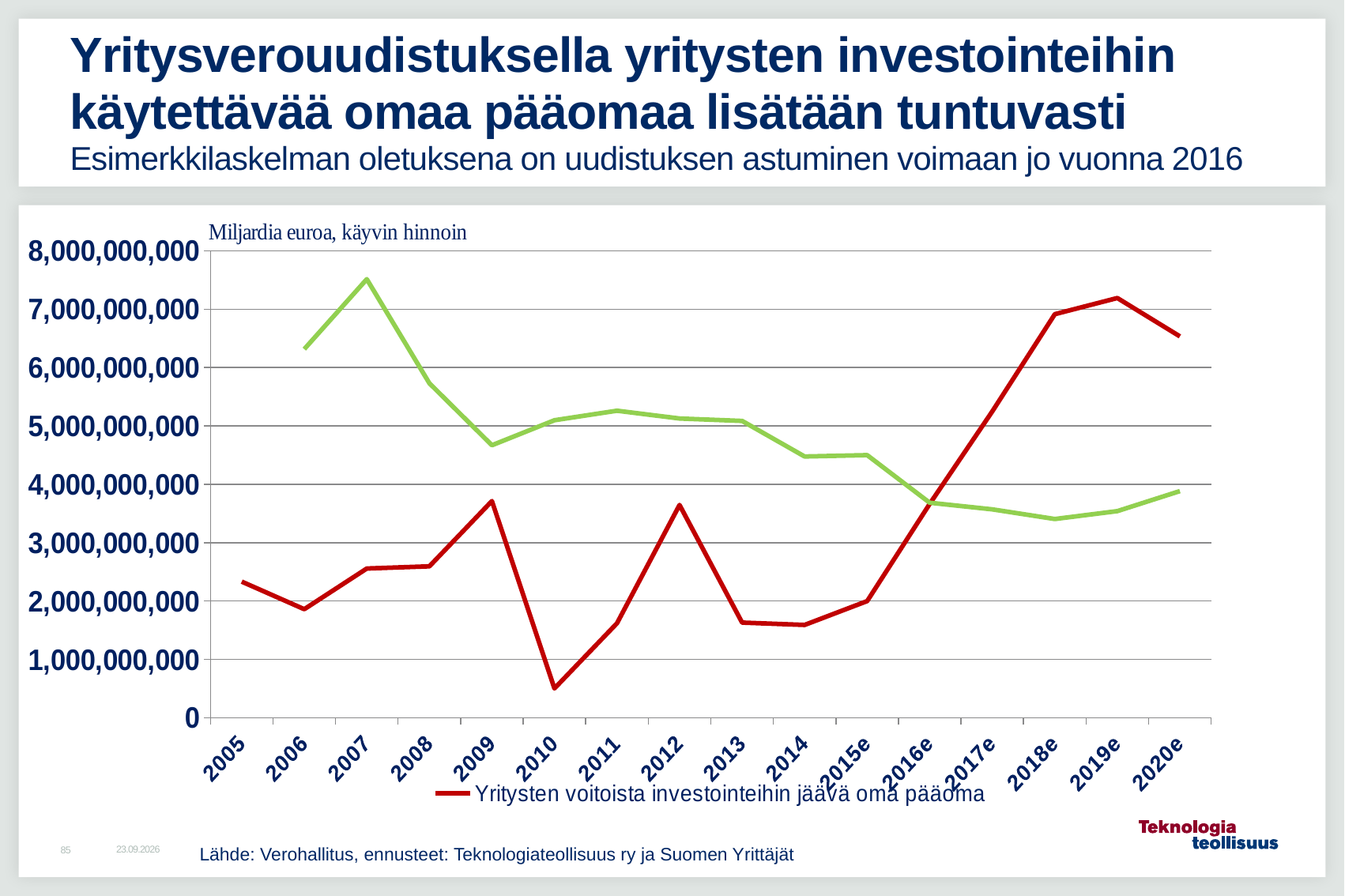
What kind of chart is shown on the slide? line chart In 2010, which line has the larger value, the red line or the green line? the green line In which year does the red line (Yritysten voitoista investointeihin jäävä oma pääoma) reach its lowest value? 2010 What unit note is printed above the y axis of the chart? Miljardia euroa, käyvin hinnoin In which year does the red line (Yritysten voitoista investointeihin jäävä oma pääoma) reach its highest value? 2019e Does the red line rise or fall between 2015e and 2018e? rise Is the value of the green line in 2007 greater or less than 7,000,000,000? greater How many series does the chart's legend list? 1 How many years are shown on the x axis of the chart? 16 In which year does the green line reach its highest value? 2007 What is the name of the series listed in the legend? Yritysten voitoista investointeihin jäävä oma pääoma Is the value of the red line in 2010 greater or less than 1,000,000,000? less